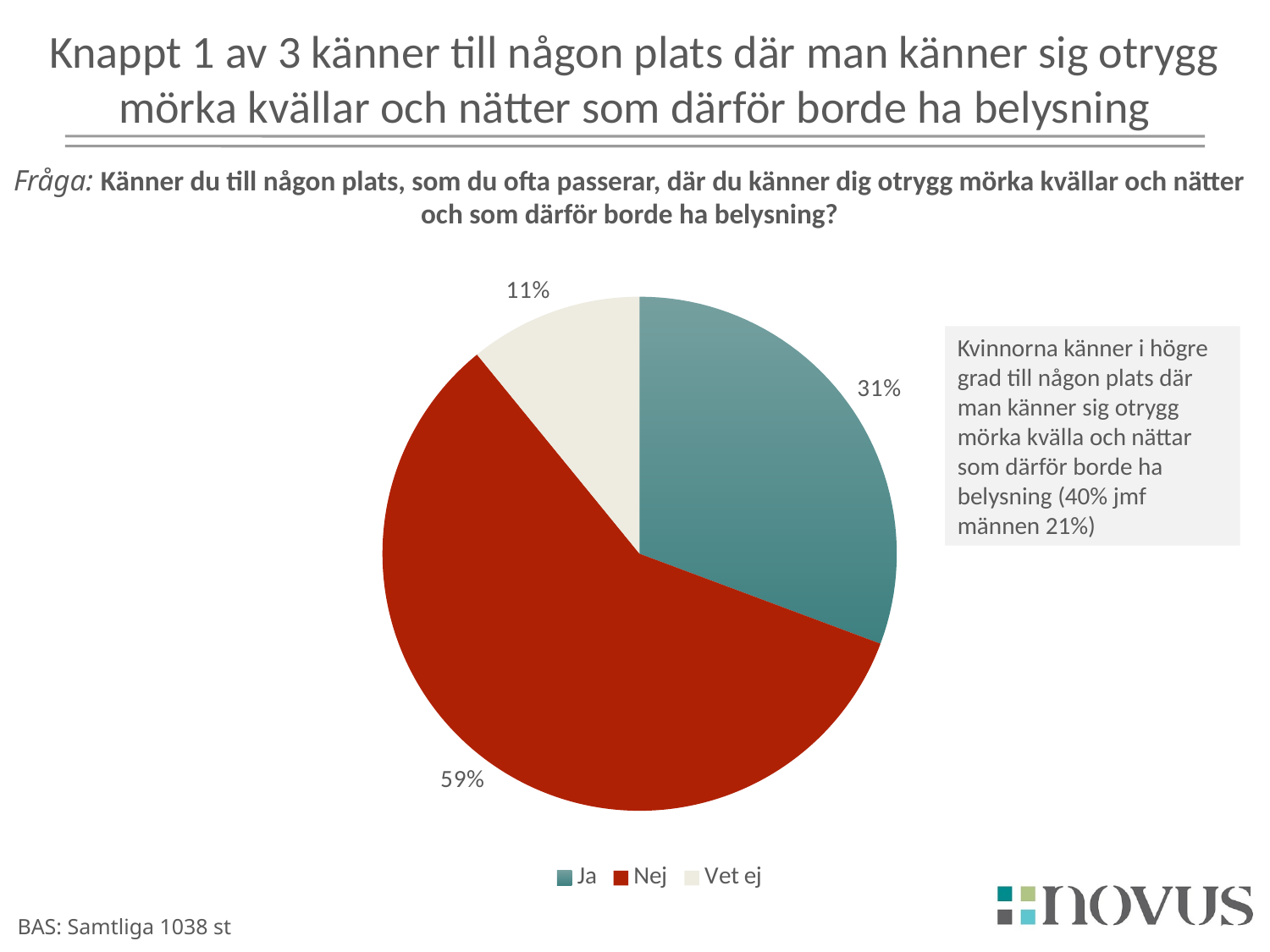
What percentage of respondents answered "Vet ej"? 11% What percentage of respondents answered "Ja"? 31% Which answer has the smallest share of the pie? Vet ej What percentage of respondents answered "Nej"? 59% How many entries does the legend list? 3 What kind of chart is shown on the slide? pie chart What colour is the "Nej" slice? red Which is larger, the share for "Ja" or the share for "Vet ej"? Ja Which answer has the largest share of the pie? Nej What is the base (BAS) stated on the slide? Samtliga 1038 st How many slices does the pie chart have? 3 What is the difference in percentage points between "Nej" and "Ja"? 28